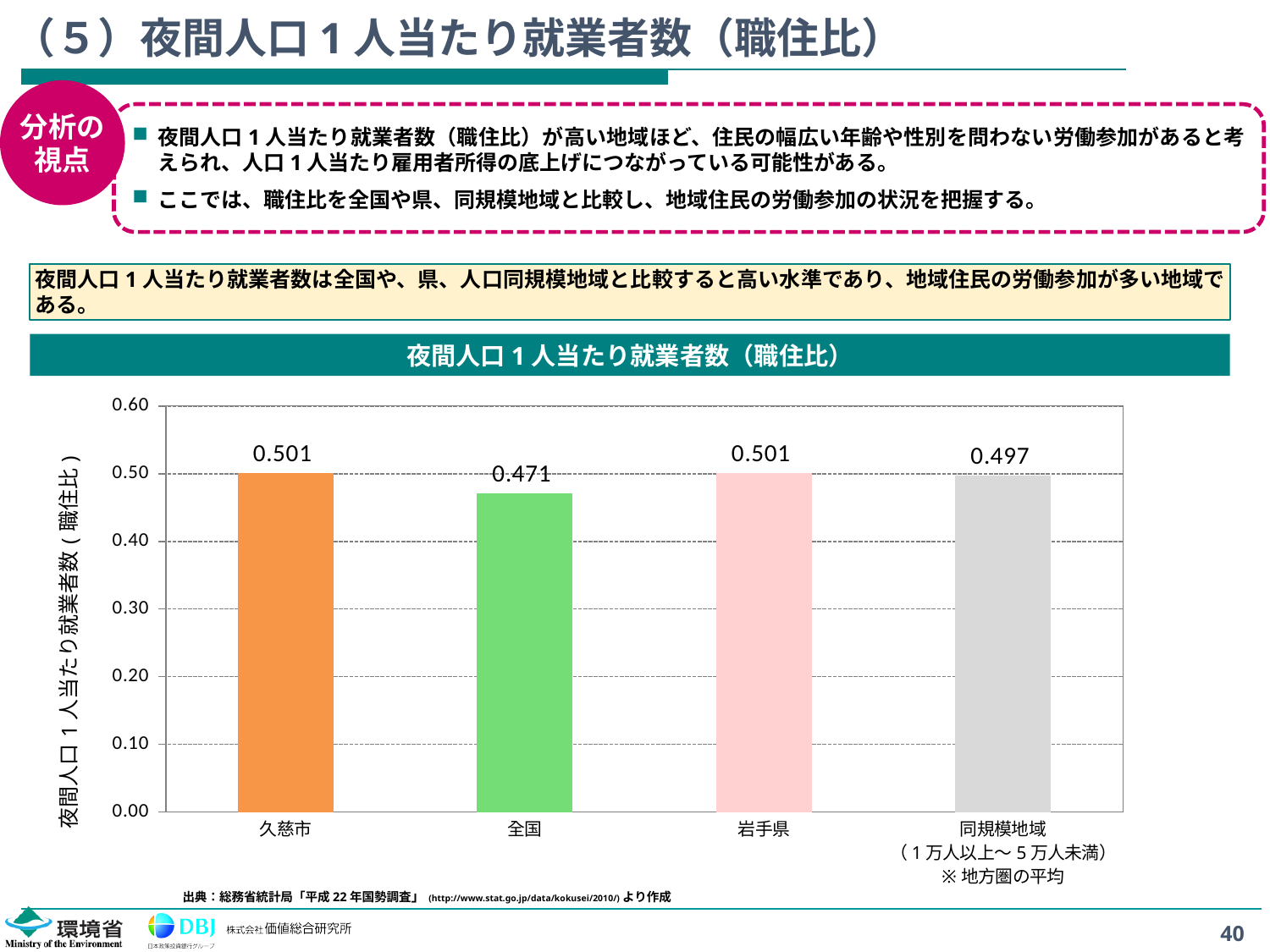
Which is larger, the value for 久慈市 or the value for 全国? 久慈市 What kind of chart is shown on the slide? bar chart What is the value for 同規模地域（1万人以上～5万人未満） in the chart? 0.497 What is the title of the chart? 夜間人口1人当たり就業者数（職住比） What is the value for 全国 in the chart? 0.471 What is the difference between the values for 岩手県 and 同規模地域? 0.004 What is the value for 岩手県 in the chart? 0.501 What is the value for 久慈市 in the chart? 0.501 What is the difference between the values for 久慈市 and 全国? 0.030 Which category has the lowest value in the chart? 全国 Is the value for 全国 greater or less than 0.50? less How many categories are shown in the chart? 4